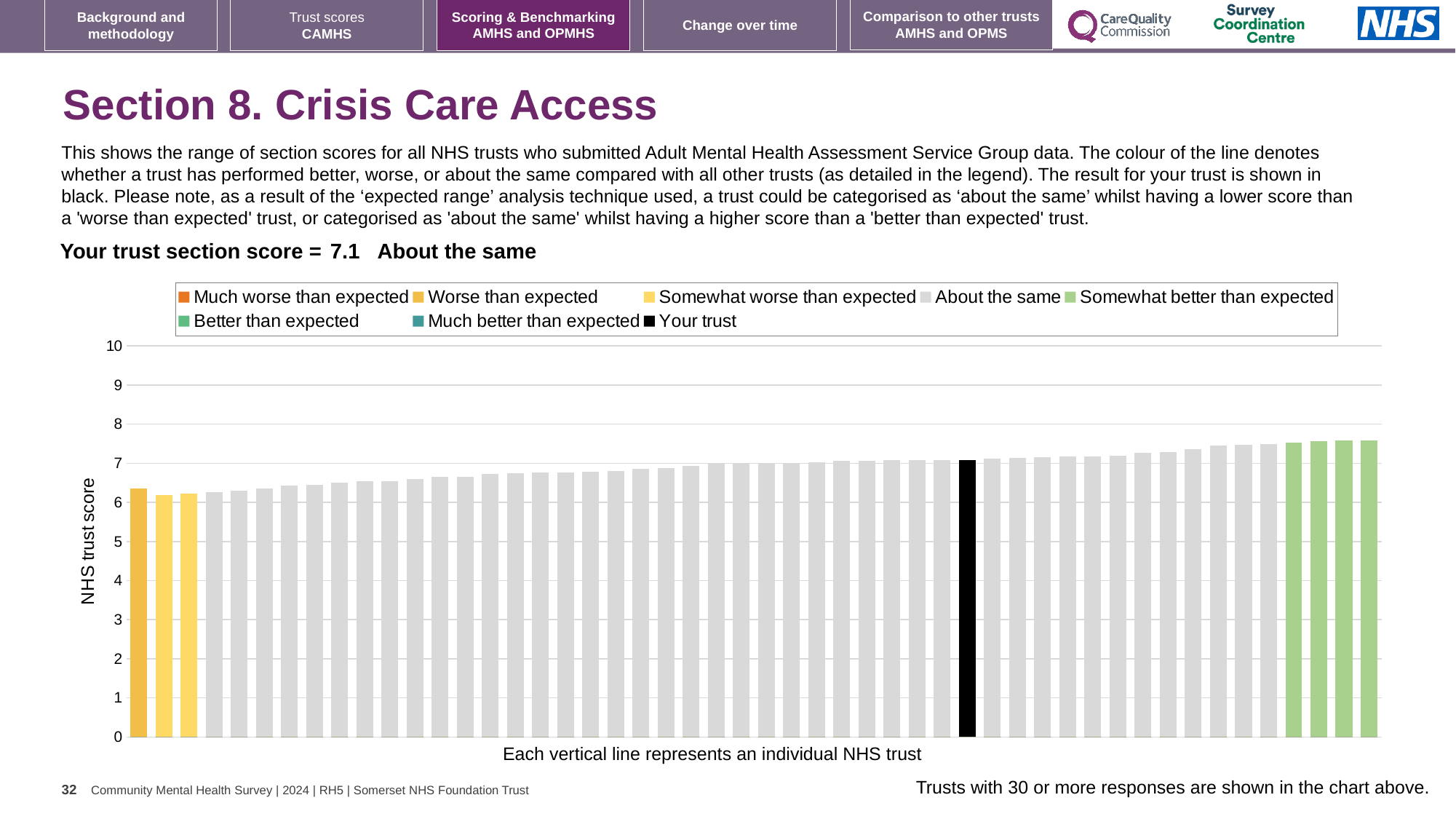
What is the label on the vertical axis of the chart? NHS trust score Which category is your trust placed in for this section? About the same Do the bar values rise or fall from left to right along the x axis? rise Is the value for the rightmost bar greater or less than 8? less What colour is the bar representing your trust? black Is the value for the leftmost (orange) bar greater or less than 7? less How many bars are coloured green (somewhat better than expected)? 4 How many entries does the chart legend list? 8 Is the value for your trust (the black bar) greater or less than 6? greater What kind of chart is shown on the slide? bar chart What is your trust's section score for Crisis Care Access? 7.1